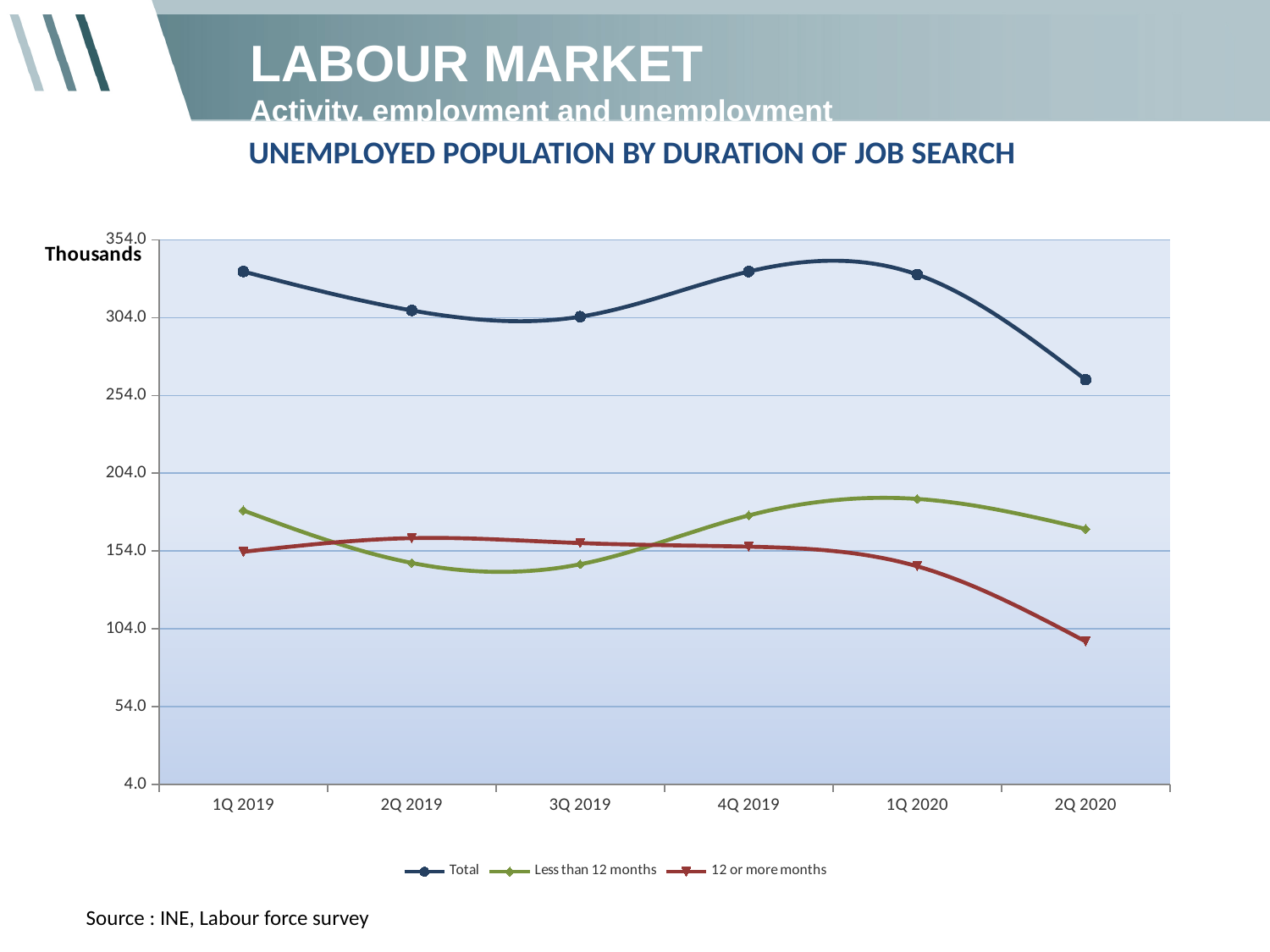
What kind of chart is shown on the slide? line chart In 2Q 2020, which is larger: Less than 12 months or 12 or more months? Less than 12 months Is the value for Less than 12 months in 1Q 2020 greater or less than 154.0? greater Is the value for Total in 2Q 2020 greater or less than 304.0? less In 2Q 2019, which is larger: Less than 12 months or 12 or more months? 12 or more months How many quarters are plotted along the x axis? 6 Is the value for Total in 1Q 2019 greater or less than 304.0? greater How many series does the legend list? 3 Does the Total series rise or fall from 1Q 2020 to 2Q 2020? fall In which quarter is the 12 or more months series at its lowest? 2Q 2020 In which quarter is the Total series at its lowest? 2Q 2020